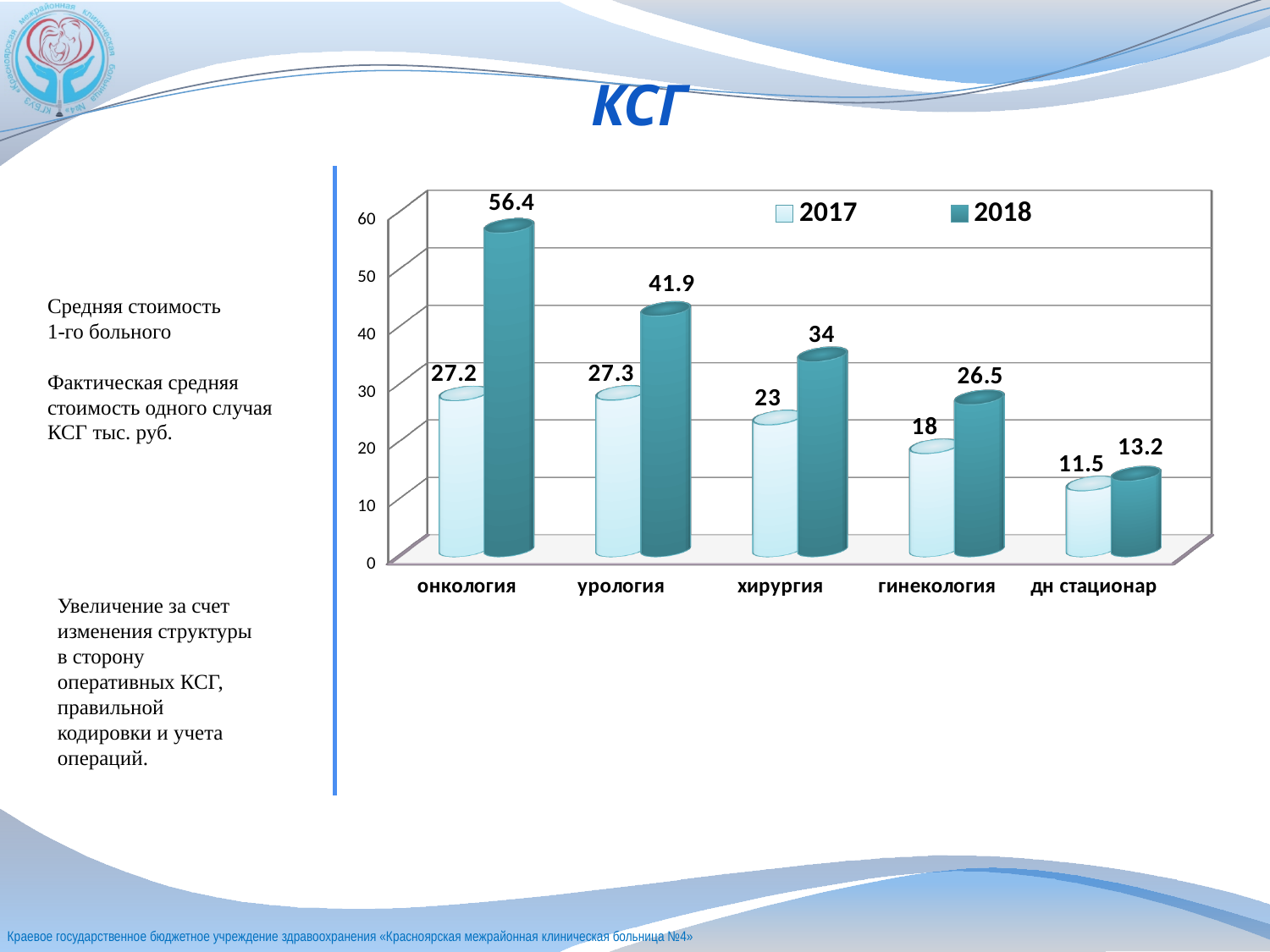
Which is larger for гинекология, the 2017 value or the 2018 value? 2018 Which category has the highest 2018 value? онкология What is the 2017 value for хирургия? 23 How many series does the legend list? 2 Which category has the lowest 2017 value? дн стационар Do the 2018 values rise or fall from онкология to дн стационар? fall How many categories are shown on the x axis? 5 Is the 2018 value for хирургия greater or less than 30? greater What is the 2017 value for дн стационар? 11.5 What is the 2018 value for онкология? 56.4 What is the difference between the 2018 and 2017 values for урология? 14.6 What kind of chart is shown on the slide? bar chart